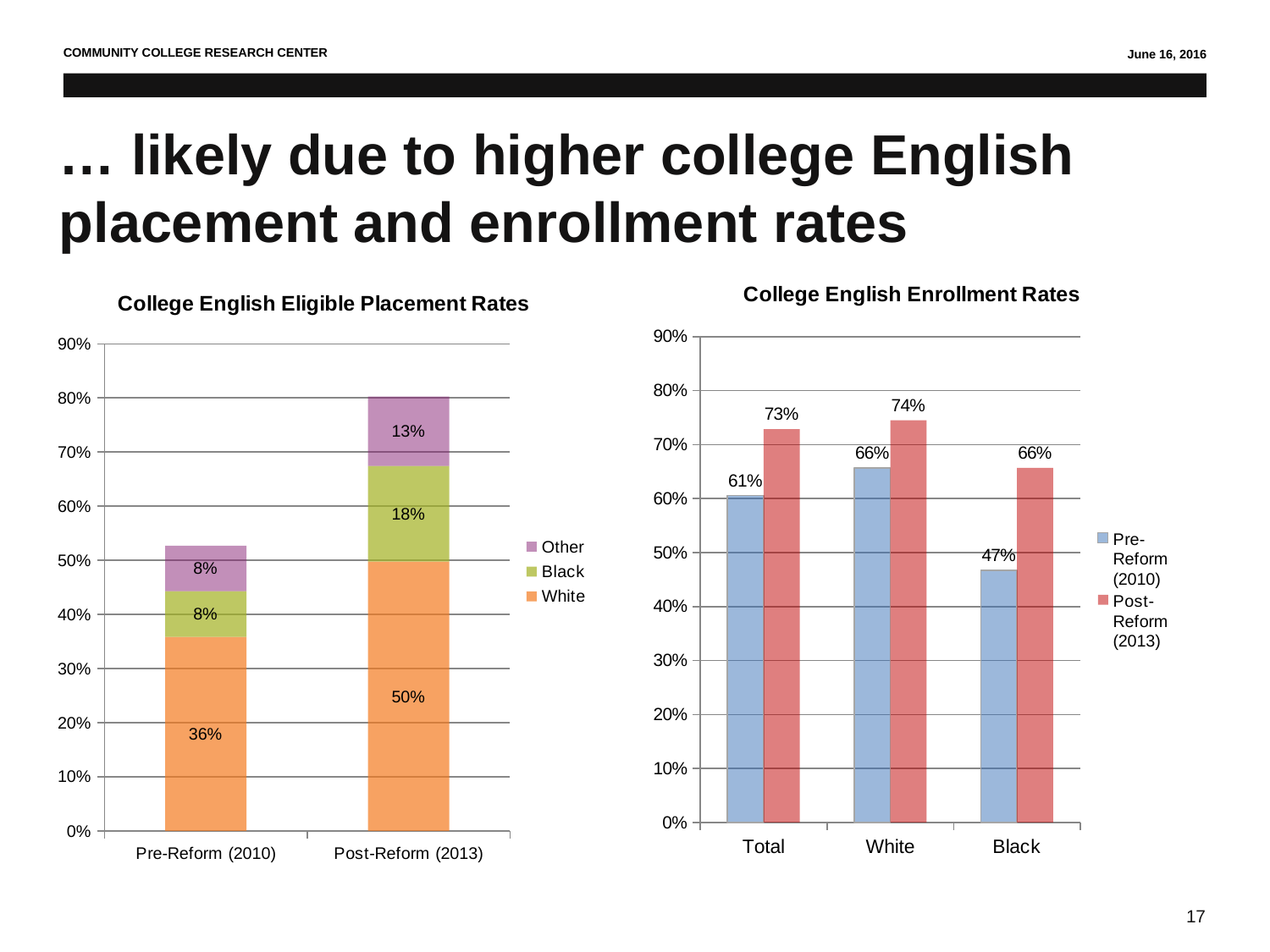
In the College English Eligible Placement Rates chart, how many series does the legend list? 3 In the College English Enrollment Rates chart, what is the Pre-Reform (2010) value for Black? 47% In the College English Enrollment Rates chart, which category has the lowest Pre-Reform (2010) value? Black In the College English Eligible Placement Rates chart, what is the total of the stacked bar for Pre-Reform (2010)? 52% In the College English Enrollment Rates chart, how many categories are shown on the x axis? 3 In the College English Enrollment Rates chart, what is the difference between the Post-Reform (2013) and Pre-Reform (2010) values for Black? 19% What kind of chart is the College English Enrollment Rates chart? Bar chart In the College English Eligible Placement Rates chart, what is the difference between the White values for Post-Reform (2013) and Pre-Reform (2010)? 14% In the College English Eligible Placement Rates chart, what is the White value for Post-Reform (2013)? 50% In the College English Eligible Placement Rates chart, what is the Black value for Pre-Reform (2010)? 8% In the College English Enrollment Rates chart, what is the Post-Reform (2013) value for White? 74% In the College English Eligible Placement Rates chart, what is the total of the stacked bar for Post-Reform (2013)? 81%